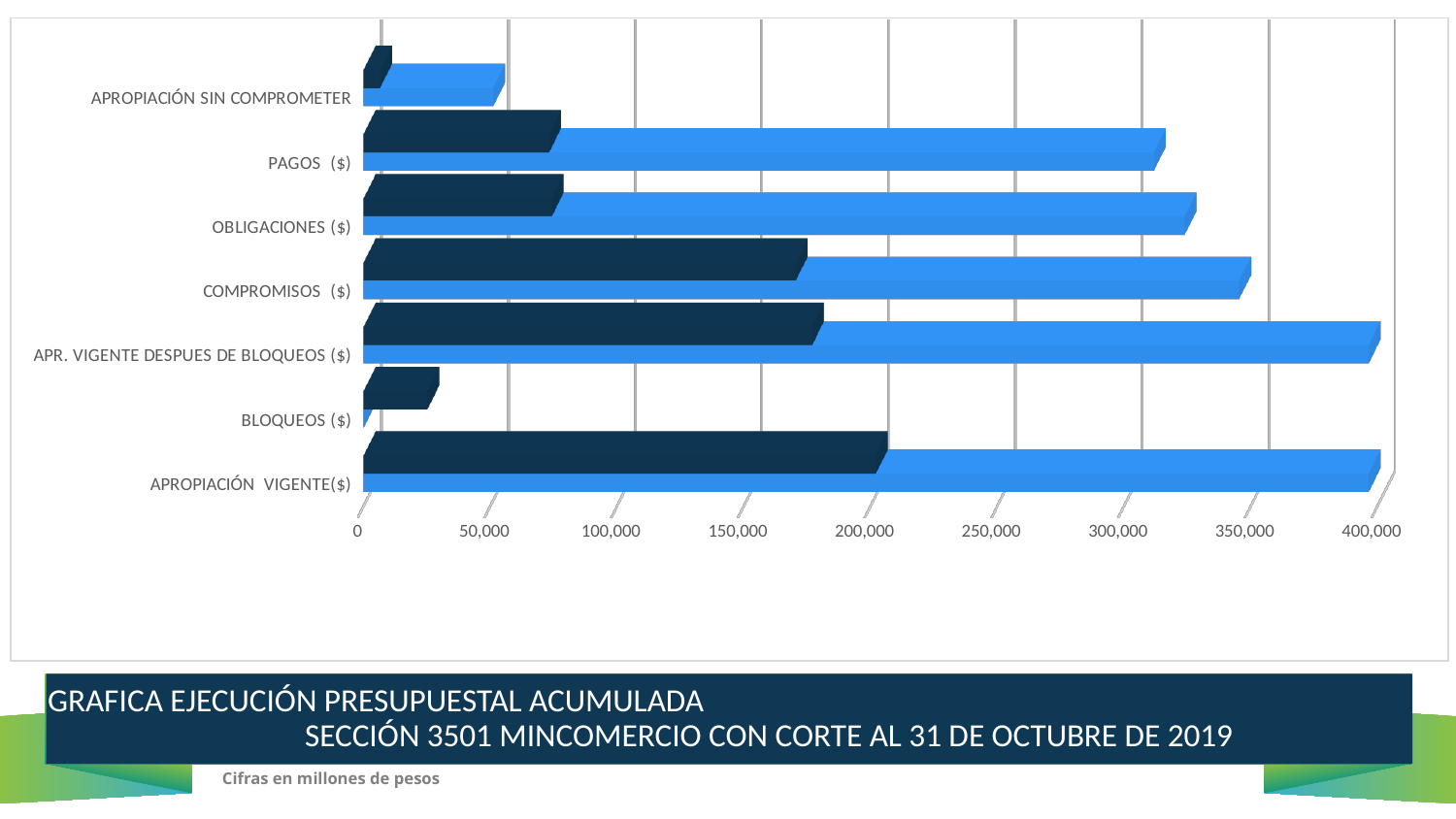
In what units are the figures in the chart expressed, according to the note on the slide? Cifras en millones de pesos Is the light blue bar for APROPIACIÓN SIN COMPROMETER greater or less than 100,000? less Is the dark navy bar for BLOQUEOS ($) greater or less than 50,000? less Is the light blue bar for COMPROMISOS ($) greater or less than 300,000? greater Which category has the longest dark navy bar? APROPIACIÓN VIGENTE($) Which category has the shortest light blue bar? BLOQUEOS ($) Which dark navy bar is longer: COMPROMISOS ($) or OBLIGACIONES ($)? COMPROMISOS ($) What is the title shown below the chart? GRAFICA EJECUCIÓN PRESUPUESTAL ACUMULADA SECCIÓN 3501 MINCOMERCIO CON CORTE AL 31 DE OCTUBRE DE 2019 How many categories are plotted on the vertical axis of the chart? 7 What kind of chart is shown on the slide? bar chart